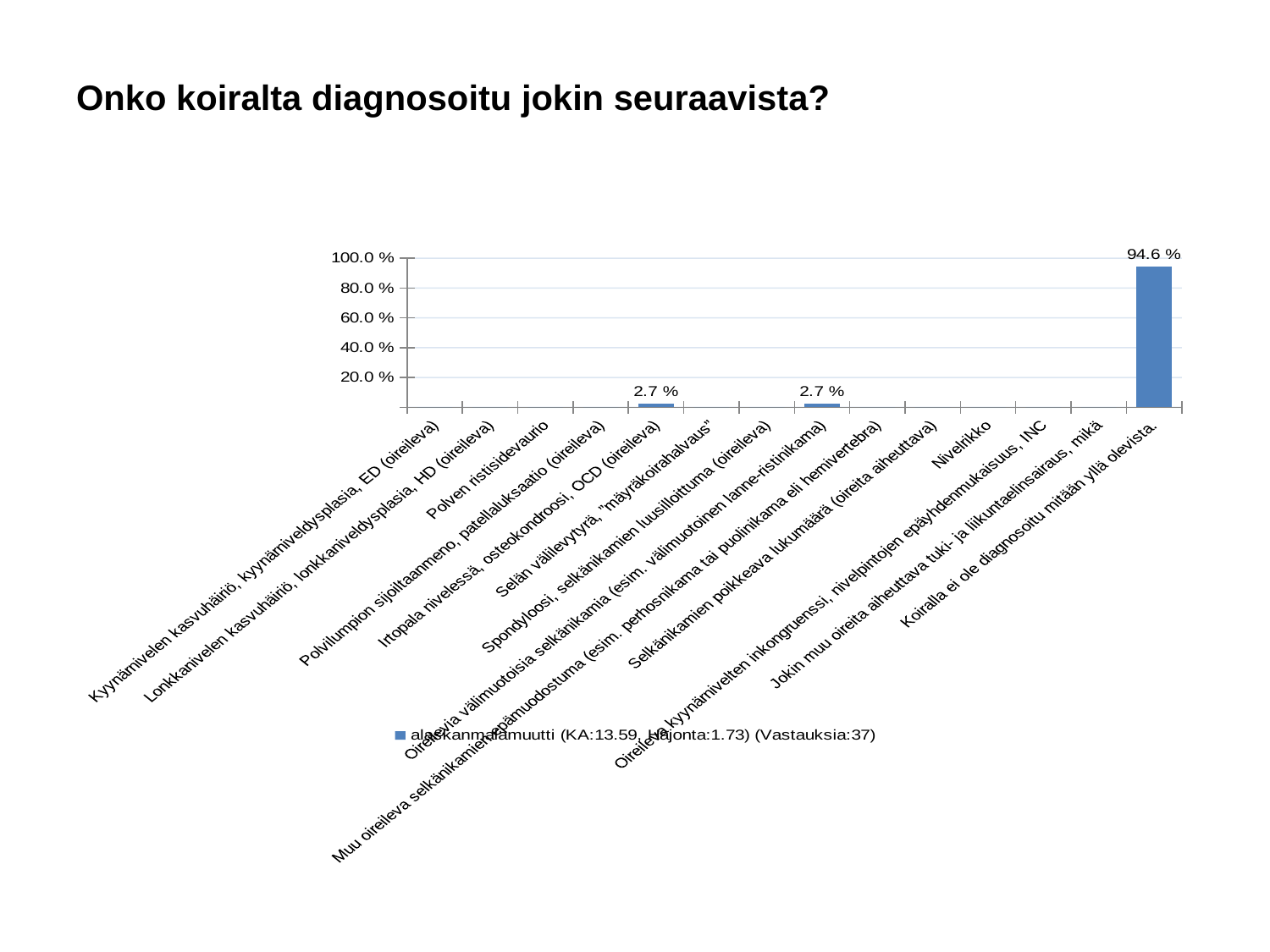
Which category has the highest value? Koiralla ei ole diagnosoitu mitään yllä olevista. What is the difference between the value for "Koiralla ei ole diagnosoitu mitään yllä olevista." and the value for "Irtopala nivelessä, osteokondroosi, OCD (oireileva)"? 91.9 % How many categories are shown on the x axis? 14 What is the title of the slide? Onko koiralta diagnosoitu jokin seuraavista? Is the value for "Koiralla ei ole diagnosoitu mitään yllä olevista." greater or less than 80.0 %? greater Is the value for "Irtopala nivelessä, osteokondroosi, OCD (oireileva)" greater or less than 20.0 %? less What is the value for "Koiralla ei ole diagnosoitu mitään yllä olevista."? 94.6 % How many series does the legend list? 1 What is the value for "Oireileva välimuotoisia selkänikamia (esim. välimuotoinen lanne-ristinikama)"? 2.7 % What is the value for "Irtopala nivelessä, osteokondroosi, OCD (oireileva)"? 2.7 % Which is larger: the value for "Koiralla ei ole diagnosoitu mitään yllä olevista." or the value for "Oireileva välimuotoisia selkänikamia (esim. välimuotoinen lanne-ristinikama)"? Koiralla ei ole diagnosoitu mitään yllä olevista. What kind of chart is shown on the slide? bar chart